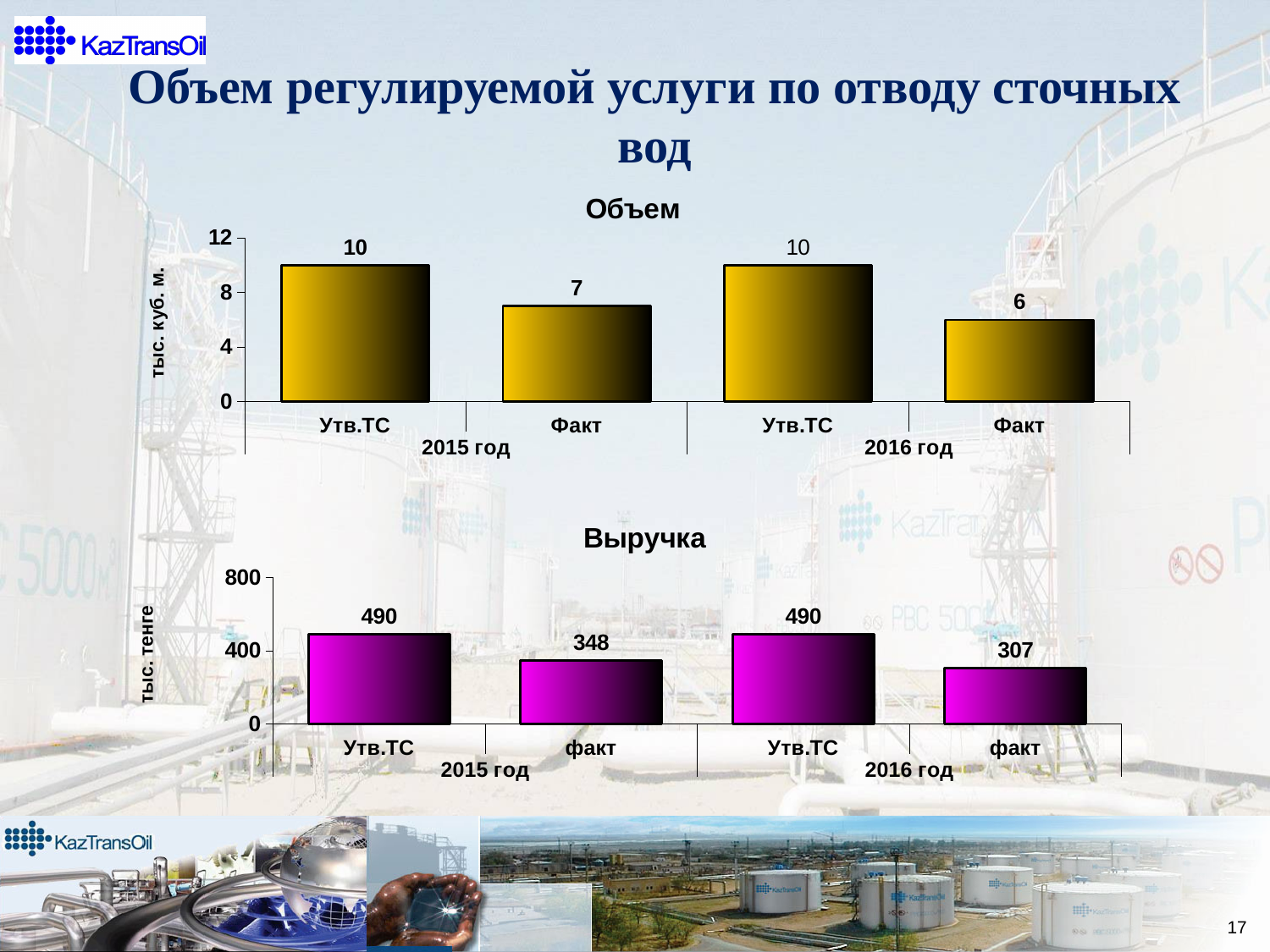
In the "Объем" chart, what is the value for Факт in 2015 год? 7 In the "Объем" chart, what is the value for Утв.ТС in 2016 год? 10 In the "Выручка" chart, what is the difference between Утв.ТС and факт for 2016 год? 183 What kind of chart is the "Выручка" chart? bar chart In the "Выручка" chart, what is the value for факт in 2016 год? 307 In the "Выручка" chart, what is the value for факт in 2015 год? 348 In the "Выручка" chart, which bar is the lowest? факт for 2016 год In the "Объем" chart, what is the value for Факт in 2016 год? 6 In the "Объем" chart, how many bars are plotted? 4 In the "Объем" chart, which is lower: Факт for 2015 год or Факт for 2016 год? Факт for 2016 год In the "Объем" chart, what is the difference between Утв.ТС and Факт for 2015 год? 3 In the "Выручка" chart, is the value for Утв.ТС in 2015 год greater or less than 400? greater